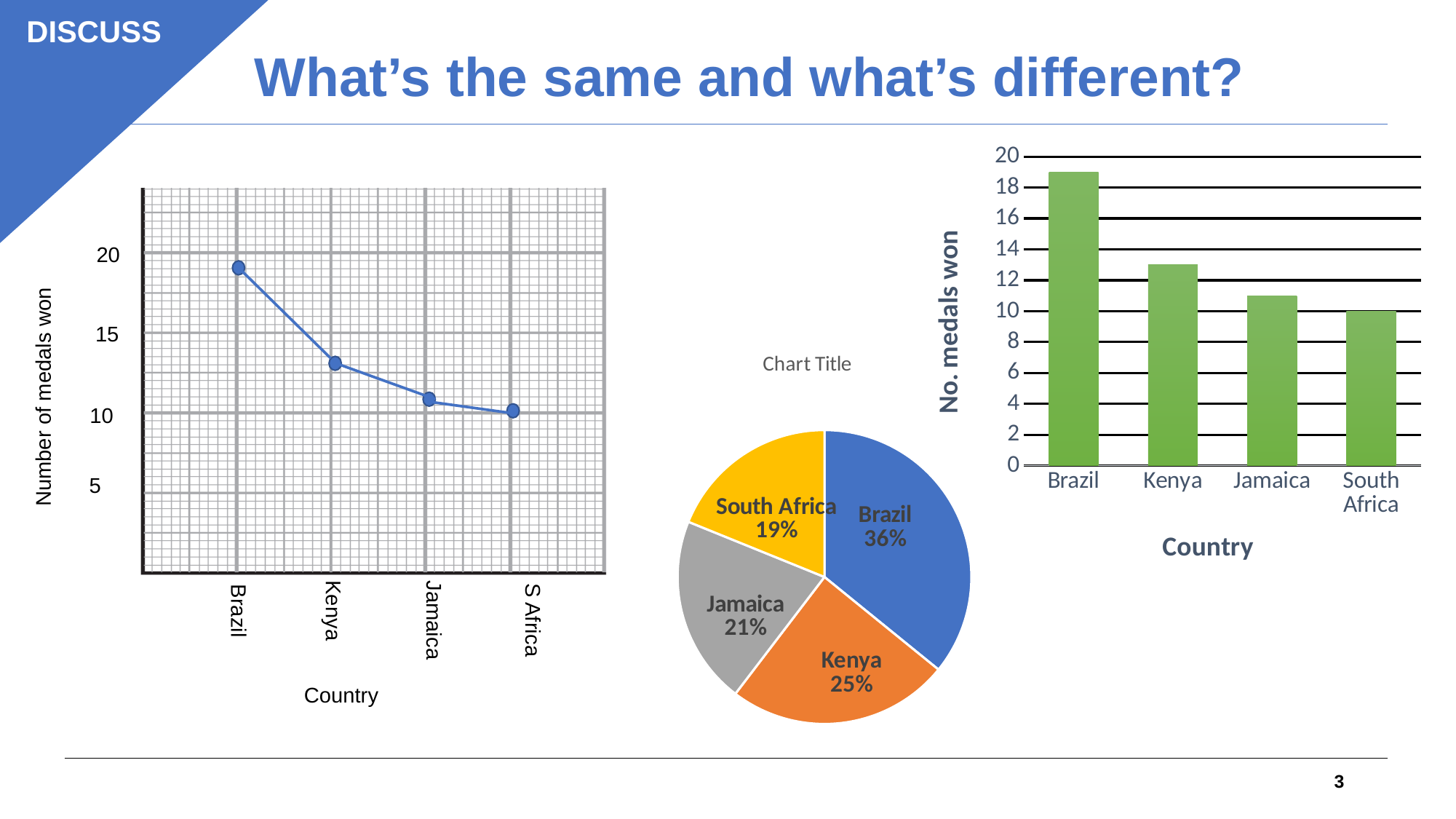
In the line chart on the left, do the values rise or fall from Brazil to S Africa? fall In the bar chart on the right, which is larger, the value for Kenya or the value for Jamaica? Kenya In the pie chart, how many slices are there? 4 In the pie chart, what is the difference between Brazil's share and Jamaica's share? 15% In the pie chart, what percentage is shown for Kenya? 25% In the bar chart on the right, is the value for Brazil greater or less than 18? greater In the pie chart, which country has the largest slice? Brazil In the bar chart on the right, is the value for Kenya greater or less than 12? greater In the bar chart on the right, which country has the tallest bar? Brazil In the pie chart, what share does Brazil have? 36% In the pie chart, which country has the smallest slice? South Africa What type of chart is the chart on the right of the slide? bar chart